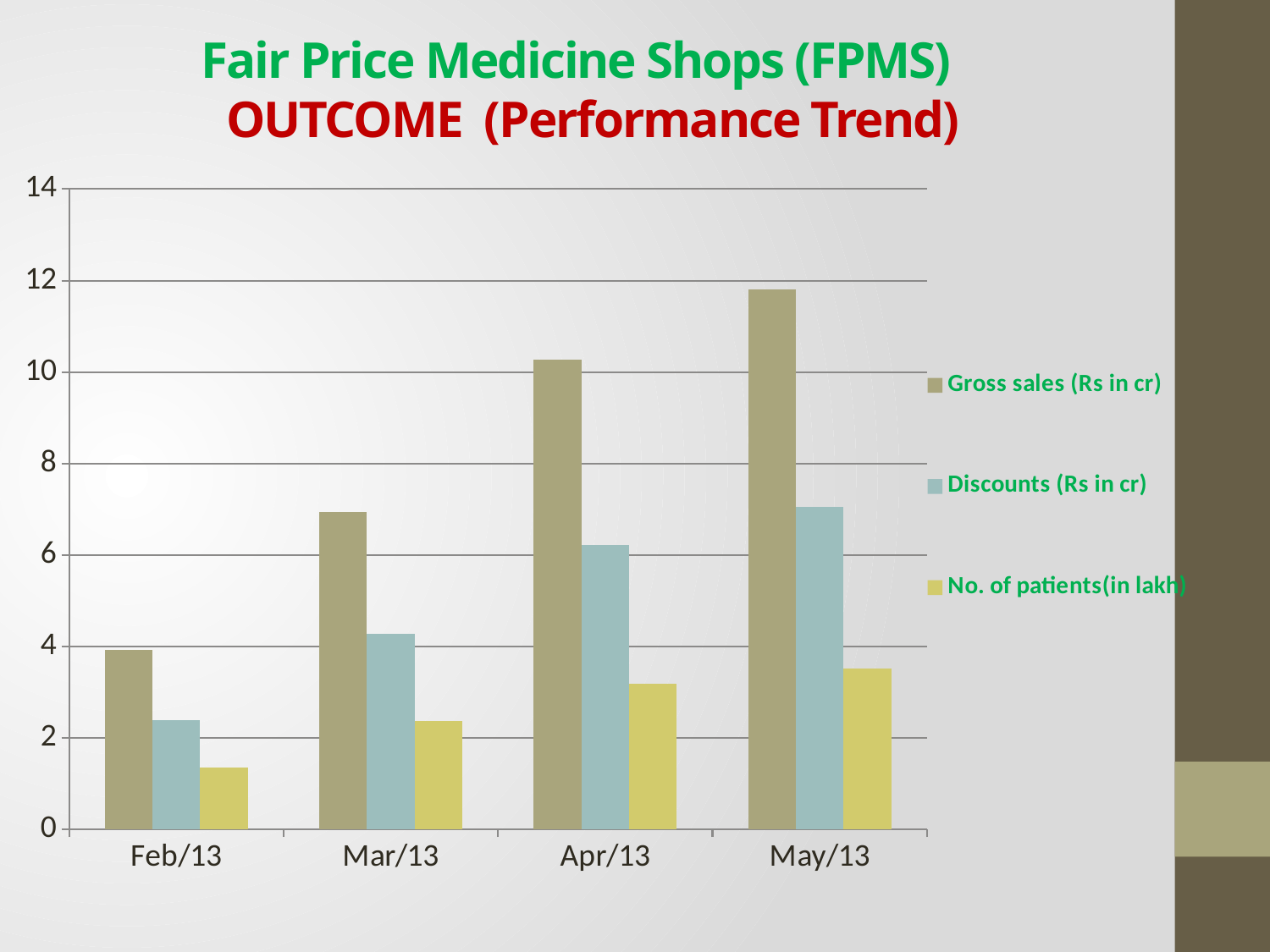
Which is larger: Discounts (Rs in cr) in Apr/13 or Gross sales (Rs in cr) in Feb/13? Discounts (Rs in cr) in Apr/13 Is the Gross sales (Rs in cr) value for Apr/13 greater or less than 10? greater Do the Gross sales (Rs in cr) values rise or fall from Feb/13 to May/13? rise How many months are shown on the x axis? 4 Is the Discounts (Rs in cr) value for Mar/13 greater or less than 6? less Which series is shown in yellow in the legend? No. of patients(in lakh) Is the No. of patients(in lakh) value for Apr/13 greater or less than 2? greater How many series does the legend list? 3 Which month has the lowest No. of patients(in lakh)? Feb/13 What kind of chart is shown on the slide? bar chart Which month has the highest Gross sales (Rs in cr)? May/13